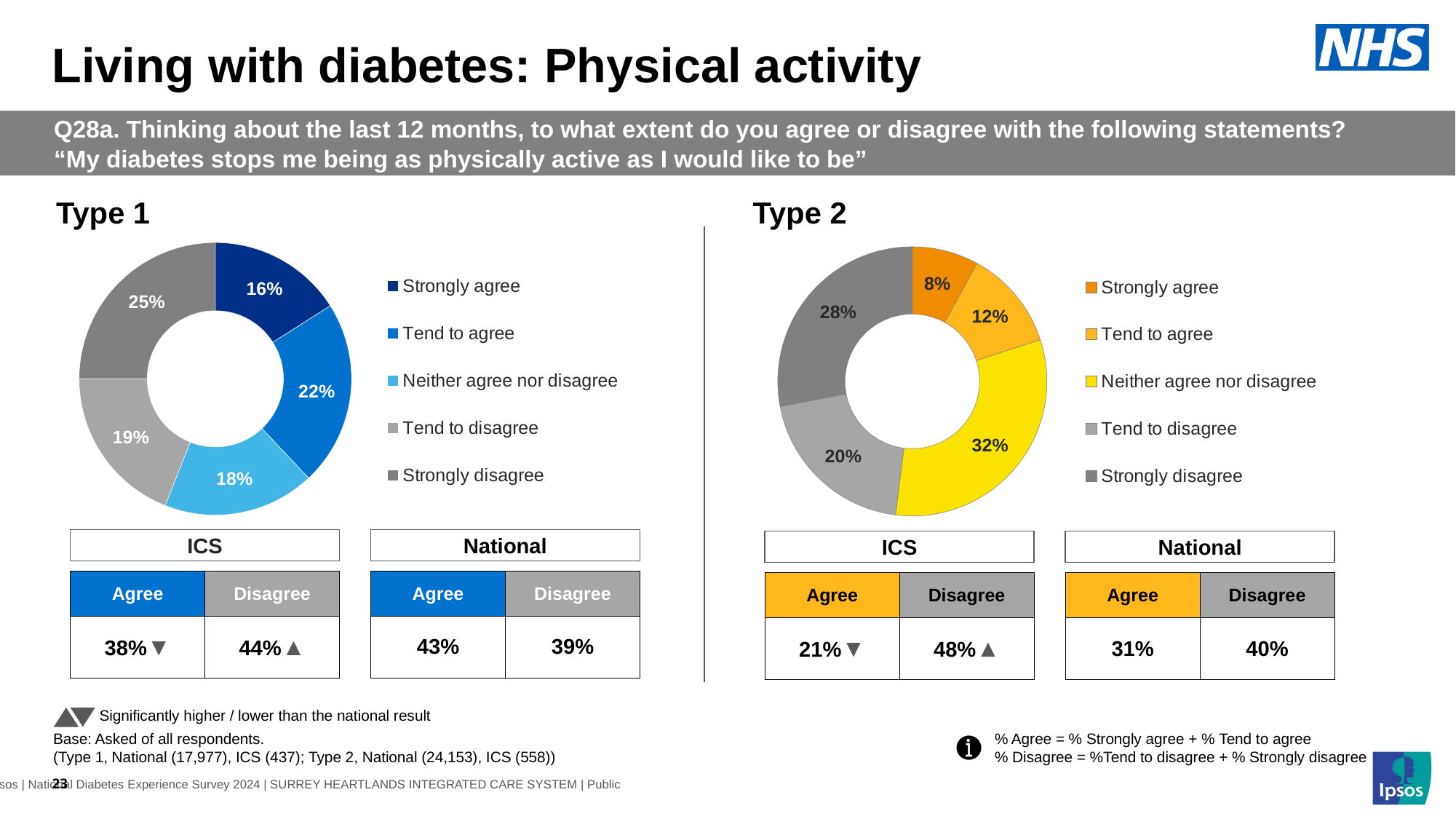
In the Type 1 chart, what is the combined share of 'Strongly agree' and 'Tend to agree'? 38% In the Type 1 chart, what percentage of respondents said 'Strongly agree'? 16% In the Type 1 chart, what percentage of respondents said 'Tend to disagree'? 19% In the Type 2 chart, what percentage of respondents said 'Neither agree nor disagree'? 32% In the Type 2 chart, what percentage of respondents said 'Strongly disagree'? 28% What colour represents 'Neither agree nor disagree' in the Type 2 chart? Yellow In the Type 2 chart, what is the difference in percentage points between 'Neither agree nor disagree' and 'Tend to agree'? 20 What kind of chart is used to show the Type 1 results? Doughnut chart In the Type 1 chart, which is larger: 'Tend to agree' or 'Neither agree nor disagree'? Tend to agree In the Type 2 chart, which response category has the smallest share? Strongly agree How many response categories does the legend of the Type 2 chart list? 5 In the Type 1 chart, which response category has the largest share? Strongly disagree